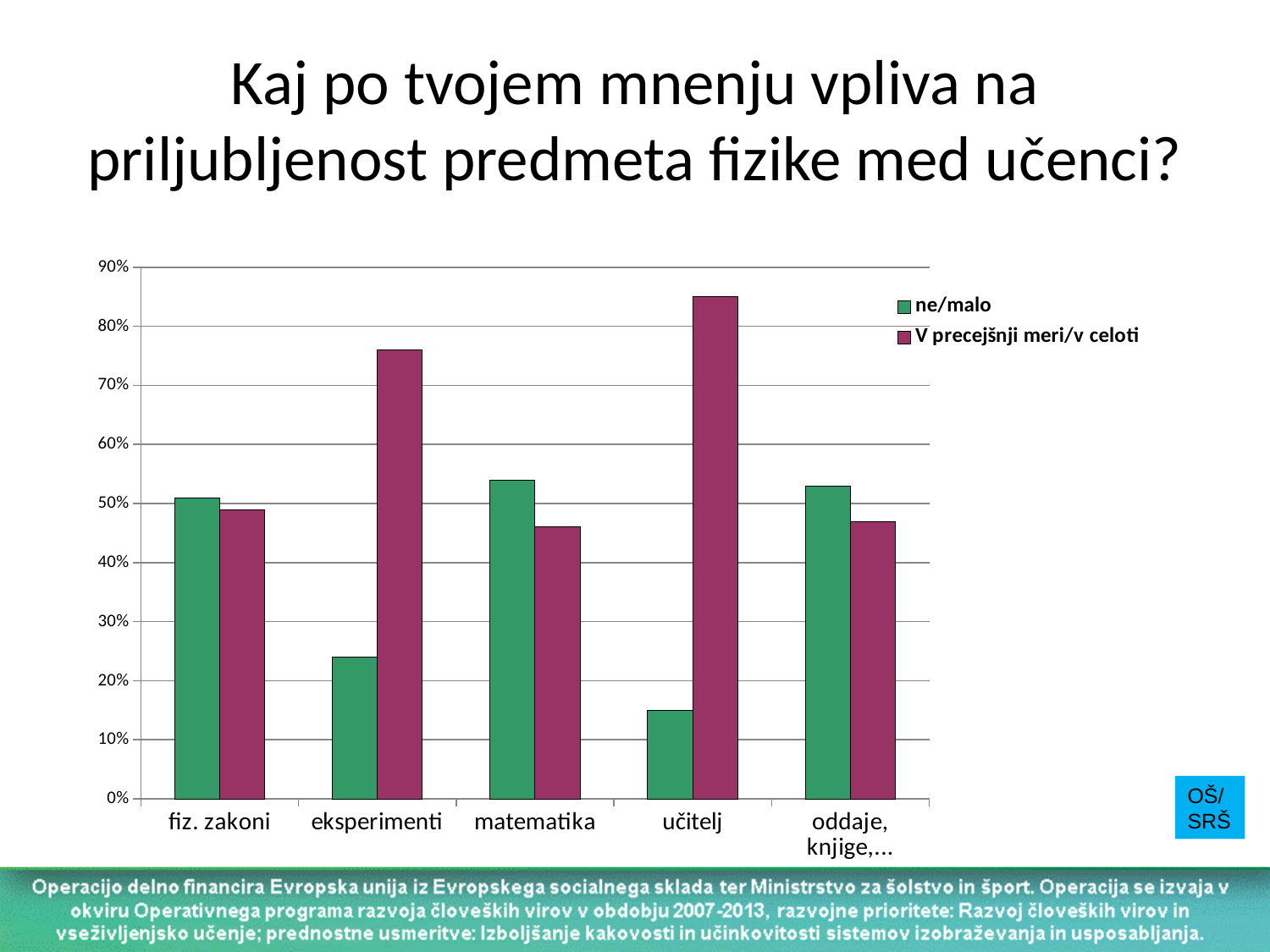
Which category has the lowest value for the series 'V precejšnji meri/v celoti'? matematika What kind of chart is shown on the slide? bar chart Which category has the highest value for the series 'V precejšnji meri/v celoti'? učitelj What colour are the bars for the series 'ne/malo'? green Which category has the lowest value for the series 'ne/malo'? učitelj Is the value for 'učitelj' in the series 'ne/malo' greater or less than 20%? less Is the value for 'eksperimenti' in the series 'ne/malo' greater or less than 30%? less For 'eksperimenti', which series has the larger value: 'ne/malo' or 'V precejšnji meri/v celoti'? V precejšnji meri/v celoti How many series does the chart's legend list? 2 For 'matematika', which series has the larger value: 'ne/malo' or 'V precejšnji meri/v celoti'? ne/malo Is the value for 'učitelj' in the series 'V precejšnji meri/v celoti' greater or less than 80%? greater How many categories are shown on the x axis of the chart? 5